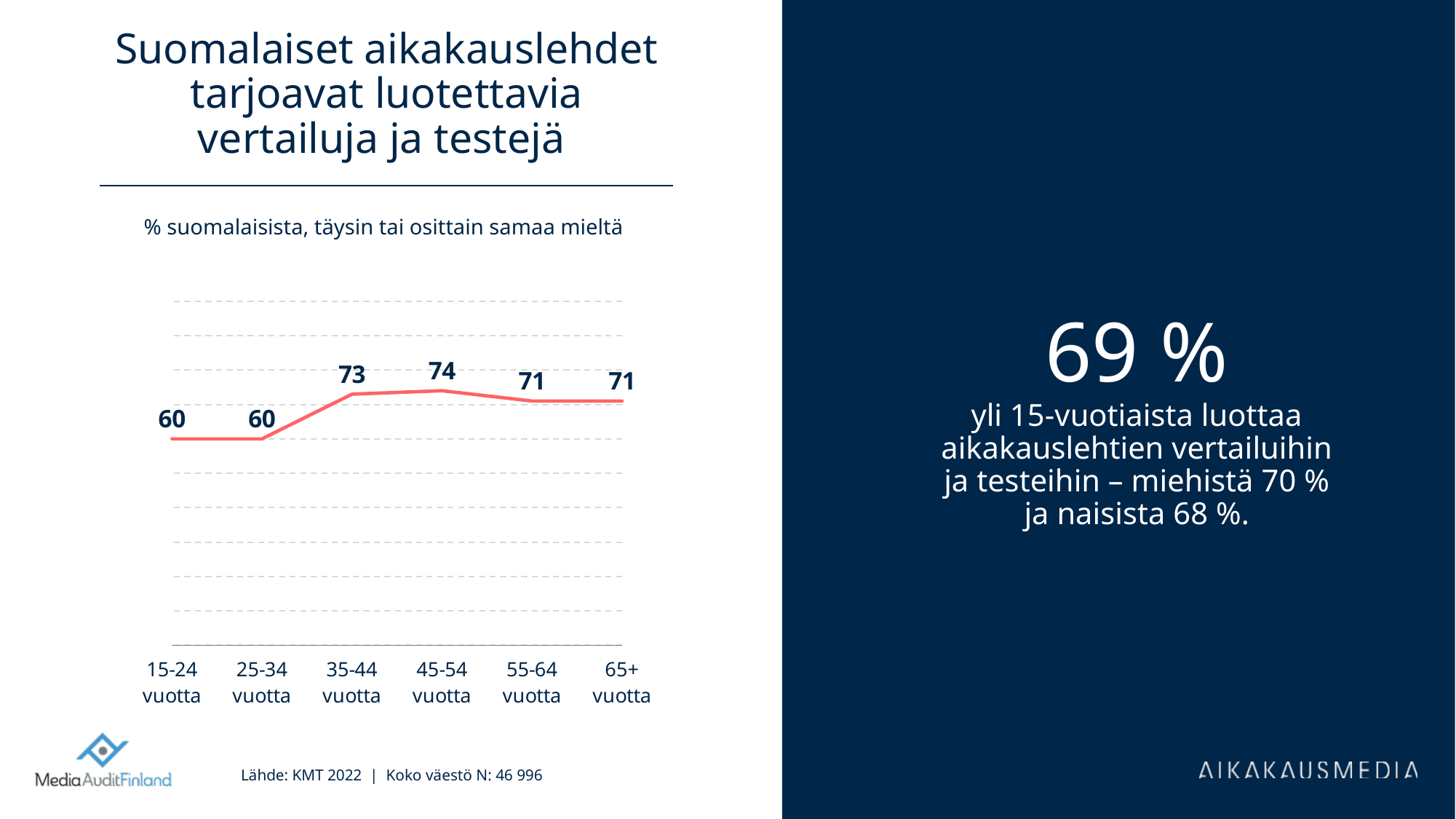
How many age groups are plotted on the chart? 6 Which age group has the highest value? 45-54 vuotta What kind of chart is shown on the slide? Line chart Do the values rise or fall from 25-34 vuotta to 35-44 vuotta? Rise Which is larger, the value for 35-44 vuotta or the value for 55-64 vuotta? 35-44 vuotta What is the value for the 35-44 vuotta age group? 73 What is the value for the 15-24 vuotta age group? 60 What is the difference between the values for 45-54 vuotta and 55-64 vuotta? 3 What is the subtitle shown above the chart? % suomalaisista, täysin tai osittain samaa mieltä What is the value for the 65+ vuotta age group? 71 What colour is the line in the chart? Red What is the difference between the values for 45-54 vuotta and 15-24 vuotta? 14